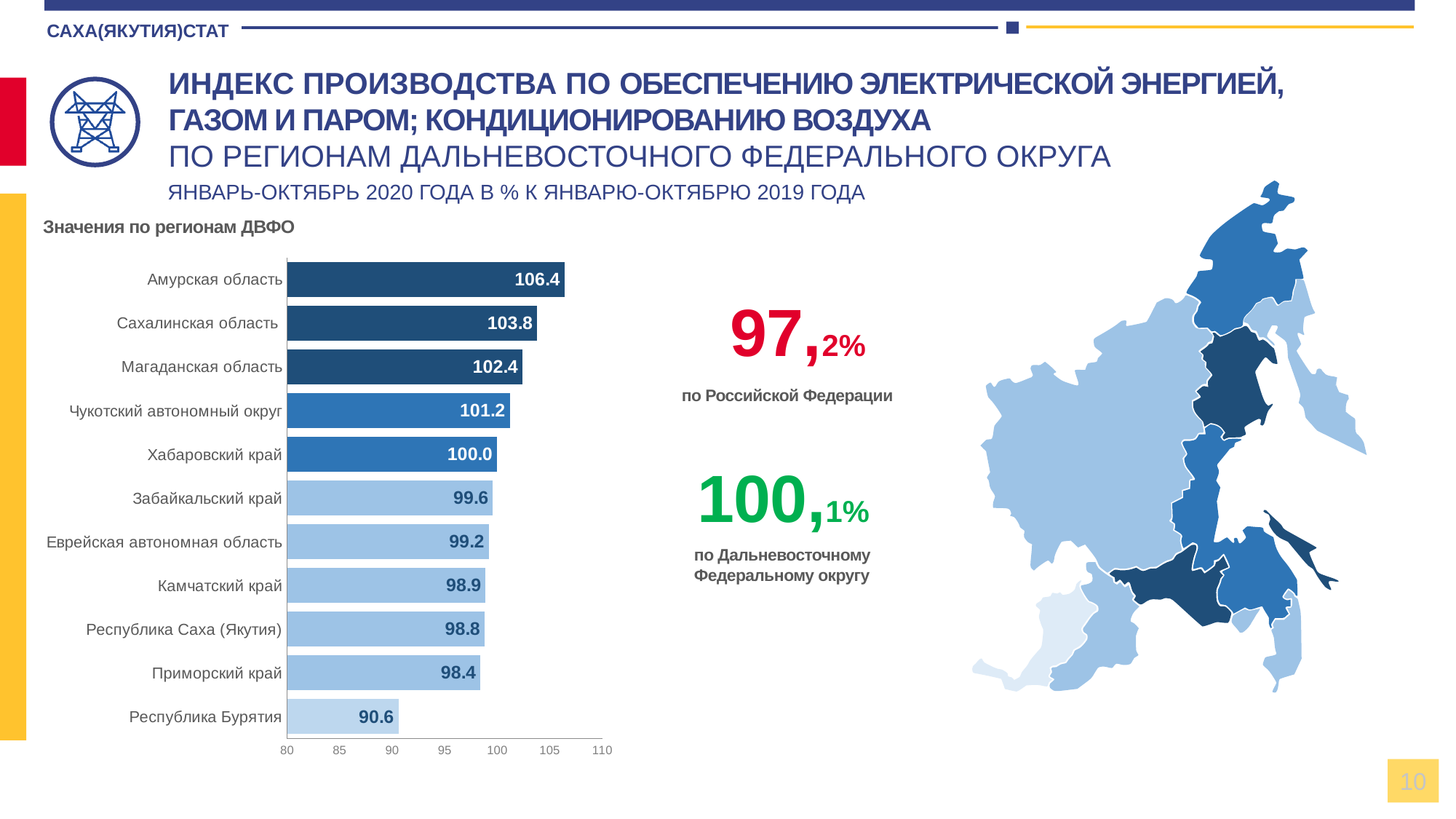
What is the difference between the values for Сахалинская область and Магаданская область? 1.4 What kind of chart is used to show the values by region? bar chart What is the difference between the values for Амурская область and Республика Бурятия? 15.8 What is the value for Хабаровский край? 100.0 Which region has the lowest value? Республика Бурятия Which region has the highest value? Амурская область What is the value for Амурская область? 106.4 What is the value for Республика Саха (Якутия)? 98.8 What is the value shown for the Russian Federation (по Российской Федерации)? 97,2% Is the value for Республика Бурятия greater or less than 95? less How many regions are shown in the bar chart? 11 Which is larger, the value for Чукотский автономный округ or the value for Приморский край? Чукотский автономный округ